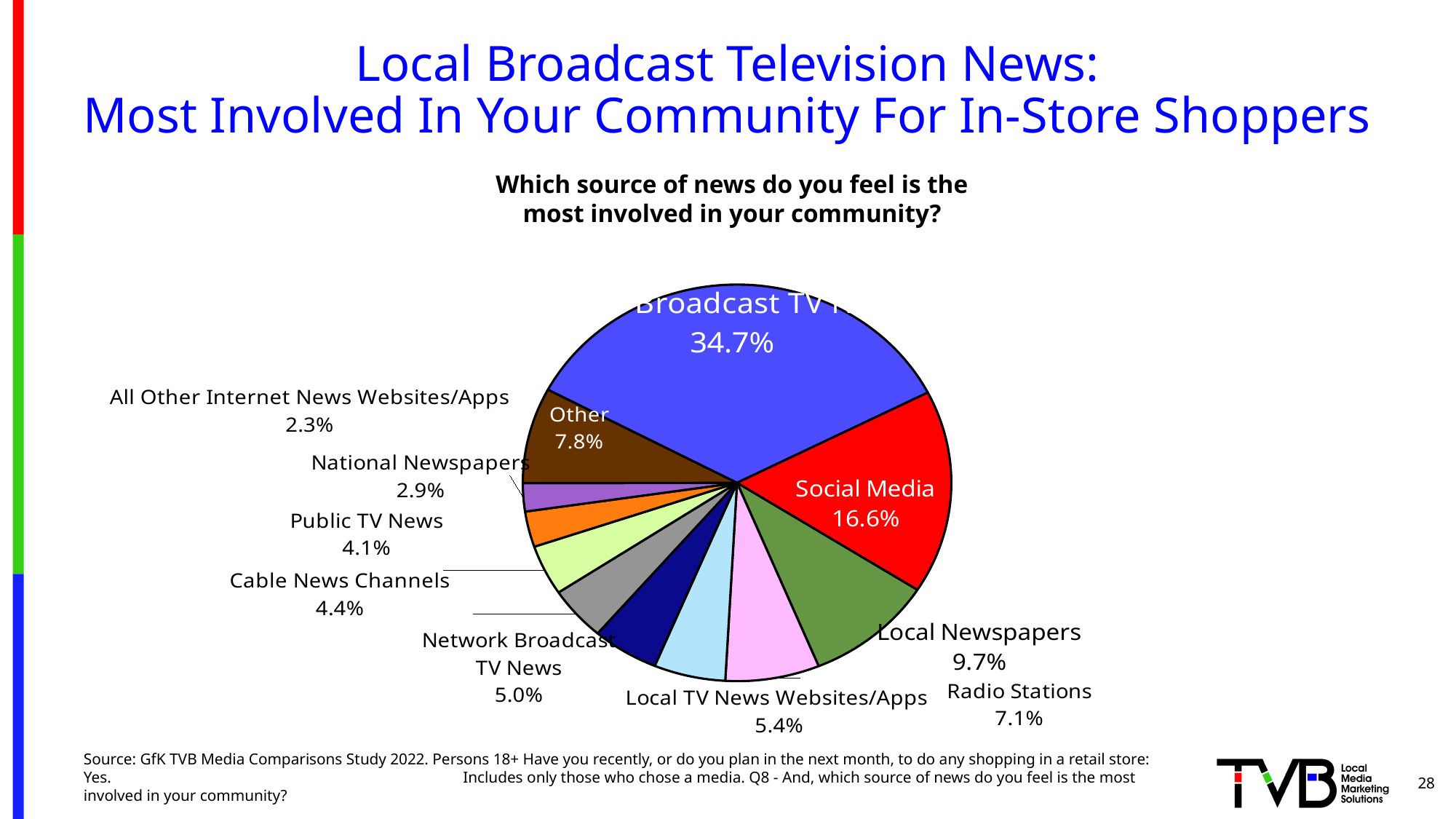
Which is larger, Cable News Channels or Public TV News? Cable News Channels What kind of chart is shown on the slide? Pie chart How many slices does the pie chart have? 11 What survey question is printed above the pie chart? Which source of news do you feel is the most involved in your community? Which category has the smallest slice of the pie? All Other Internet News Websites/Apps What percentage of respondents chose Social Media as the news source most involved in their community? 16.6% What percentage is shown for the Other slice? 7.8% What share of the pie is labelled Local Newspapers? 9.7% What percentage is shown on the largest slice of the pie? 34.7% What is the difference between Radio Stations and Local TV News Websites/Apps, in percentage points? 1.7 What value is shown for Radio Stations? 7.1% How many percentage points higher is Social Media than Local Newspapers? 6.9